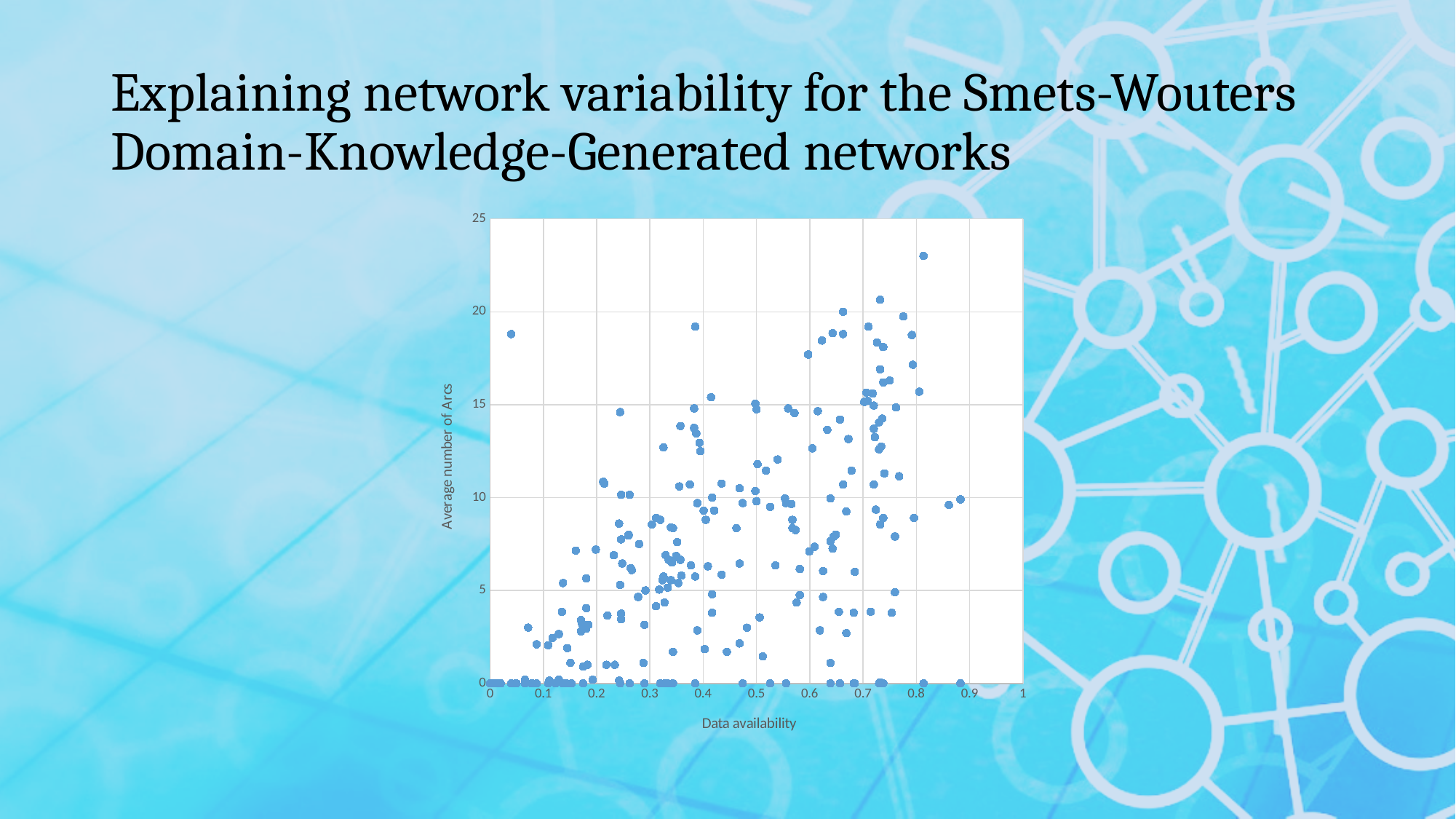
Is the Average number of Arcs for the isolated point near Data availability 0.03 greater or less than 15? greater What is the maximum value shown on the y axis of the chart? 25 Is the highest plotted value of Average number of Arcs greater or less than 20? greater Is the Data availability of the point with the highest Average number of Arcs greater or less than 0.7? greater What is the label of the y axis of the chart? Average number of Arcs What is the label of the x axis of the chart? Data availability What kind of chart is shown on the slide? scatter plot Do the values of Average number of Arcs generally rise or fall as Data availability increases along the x axis? rise